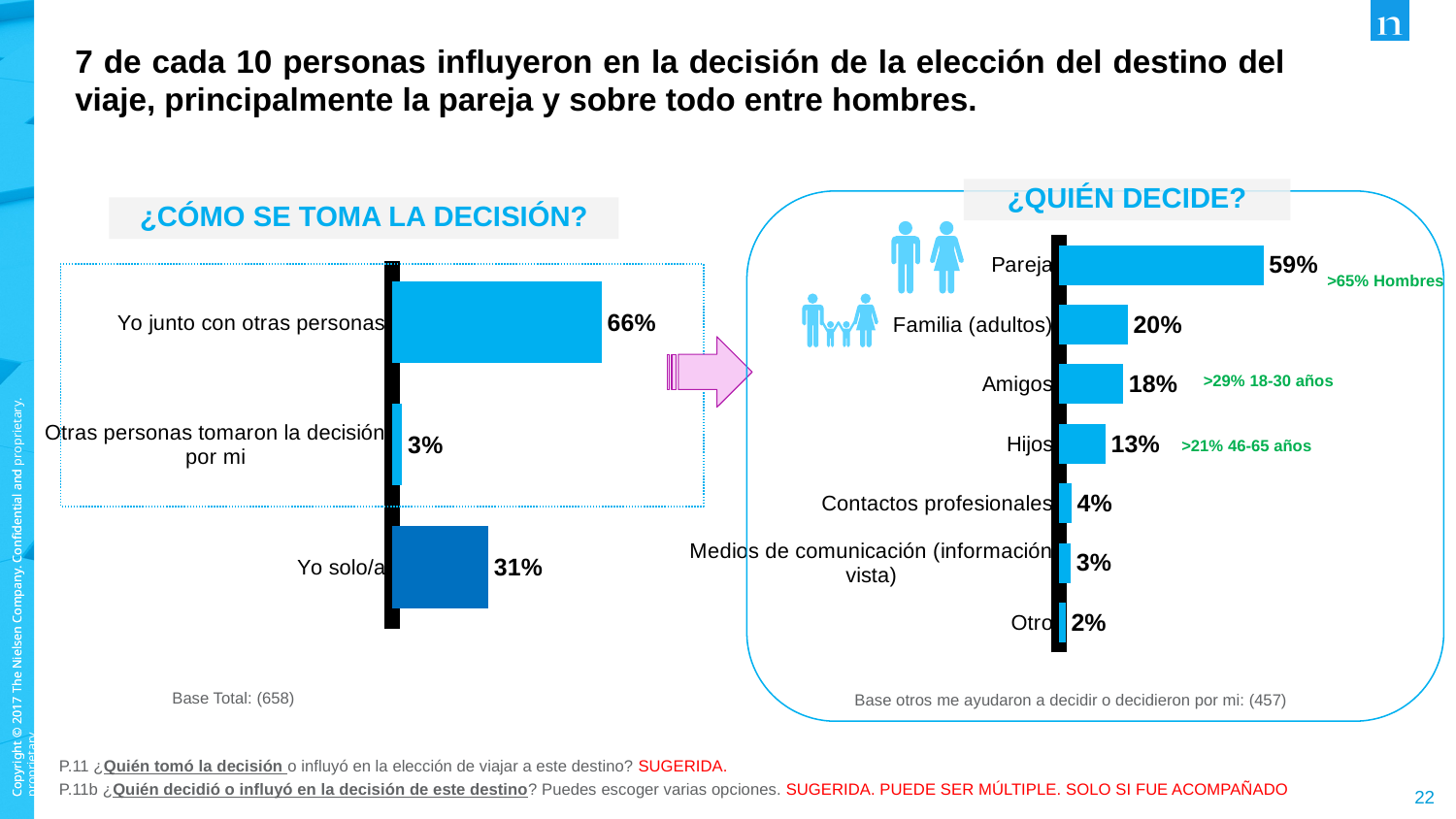
In the '¿CÓMO SE TOMA LA DECISIÓN?' chart, how many categories are shown? 3 In the '¿QUIÉN DECIDE?' chart, which is larger: 'Familia (adultos)' or 'Amigos'? Familia (adultos) In the '¿QUIÉN DECIDE?' chart, how many categories are shown? 7 In the '¿QUIÉN DECIDE?' chart, what is the value for 'Hijos'? 13% In the '¿CÓMO SE TOMA LA DECISIÓN?' chart, which category has the lowest value? Otras personas tomaron la decisión por mi In the '¿CÓMO SE TOMA LA DECISIÓN?' chart, what is the value for 'Yo junto con otras personas'? 66% In the '¿QUIÉN DECIDE?' chart, which category has the lowest value? Otro In the '¿QUIÉN DECIDE?' chart, which category has the highest value? Pareja In the '¿CÓMO SE TOMA LA DECISIÓN?' chart, what is the difference between 'Yo junto con otras personas' and 'Yo solo/a'? 35% In the '¿QUIÉN DECIDE?' chart, what is the value for 'Pareja'? 59% In the '¿CÓMO SE TOMA LA DECISIÓN?' chart, what is the value for 'Yo solo/a'? 31% What type of chart is the '¿QUIÉN DECIDE?' chart? Bar chart